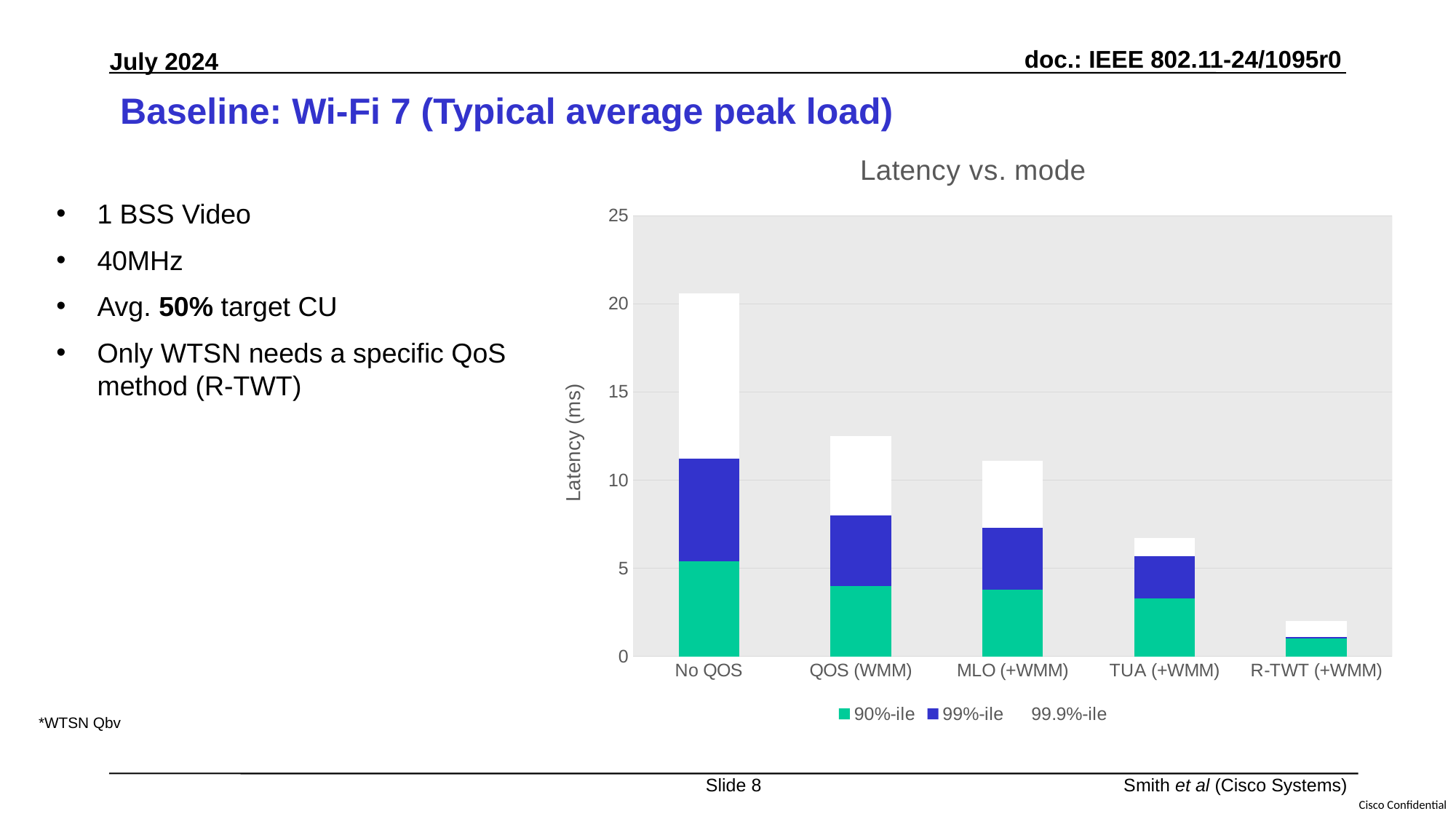
Which has the larger total latency bar, QOS (WMM) or MLO (+WMM)? QOS (WMM) How many modes (categories) are shown on the x axis of the chart? 5 How many series does the chart legend list? 3 What kind of chart is shown on the slide? stacked bar chart Which mode has the lowest total latency bar? R-TWT (+WMM) What is the title of the chart? Latency vs. mode Is the total latency bar for R-TWT (+WMM) greater or less than 5 ms? less What is the label of the y axis of the chart? Latency (ms) Do the total latency bars rise or fall moving from left to right along the x axis? fall Which mode has the highest total latency bar? No QOS Is the total latency bar for QOS (WMM) greater or less than 10 ms? greater Is the total latency bar for No QOS greater or less than 15 ms? greater